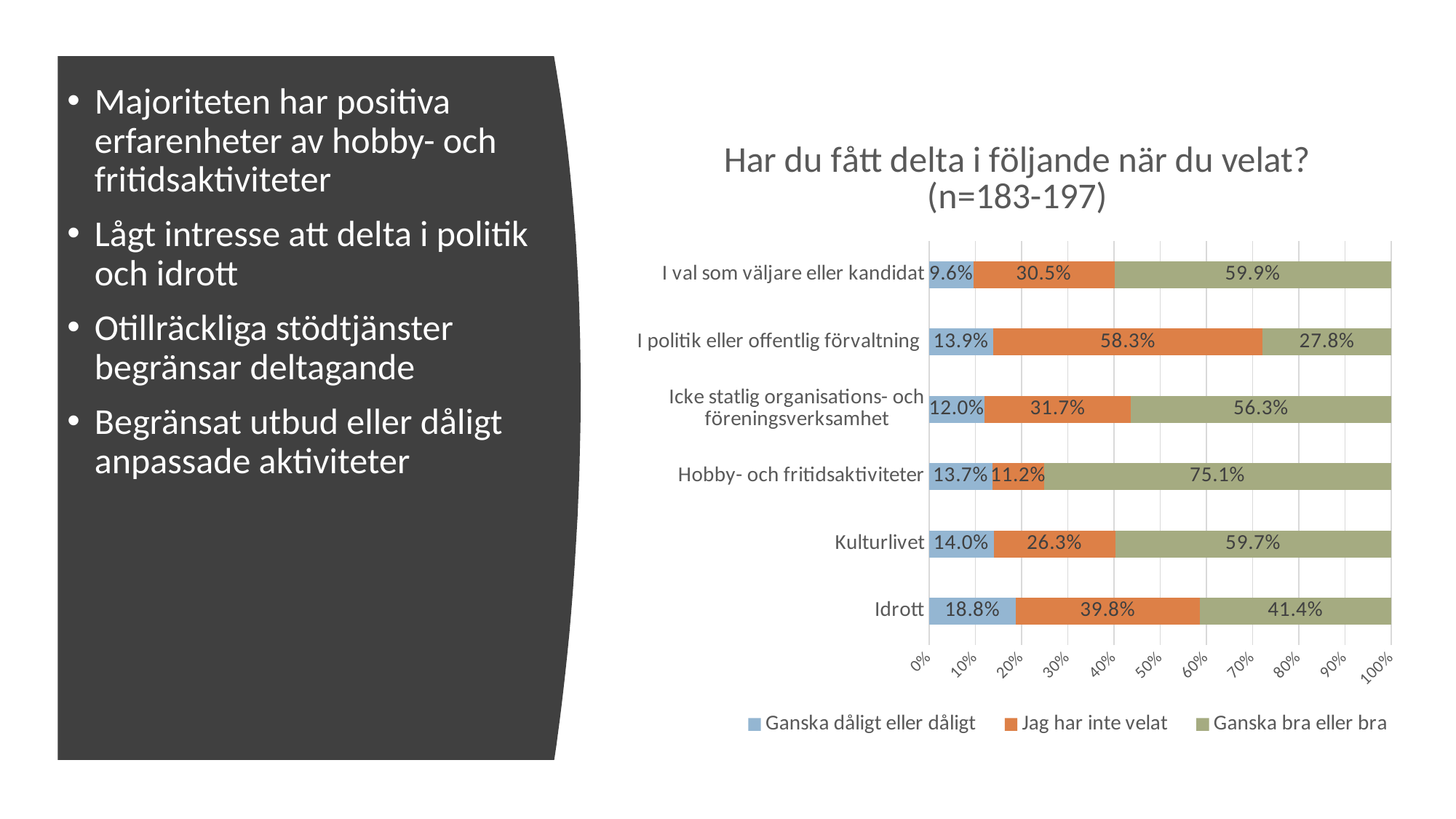
What kind of chart is shown on the slide? Stacked bar chart How many series does the legend list? 3 What is the 'Ganska dåligt eller dåligt' value for Idrott? 18.8% What is the 'Jag har inte velat' value for I politik eller offentlig förvaltning? 58.3% What is the title of the chart? Har du fått delta i följande när du velat? (n=183-197) Which category has the lowest 'Ganska dåligt eller dåligt' value? I val som väljare eller kandidat What is the difference between the 'Ganska bra eller bra' values for Kulturlivet and Idrott? 18.3 percentage points Which category has the lowest 'Ganska bra eller bra' value? I politik eller offentlig förvaltning What is the 'Ganska bra eller bra' value for Hobby- och fritidsaktiviteter? 75.1% How many categories are shown on the chart? 6 Which category has the highest 'Ganska bra eller bra' value? Hobby- och fritidsaktiviteter Which is larger for Icke statlig organisations- och föreningsverksamhet: 'Jag har inte velat' or 'Ganska bra eller bra'? Ganska bra eller bra